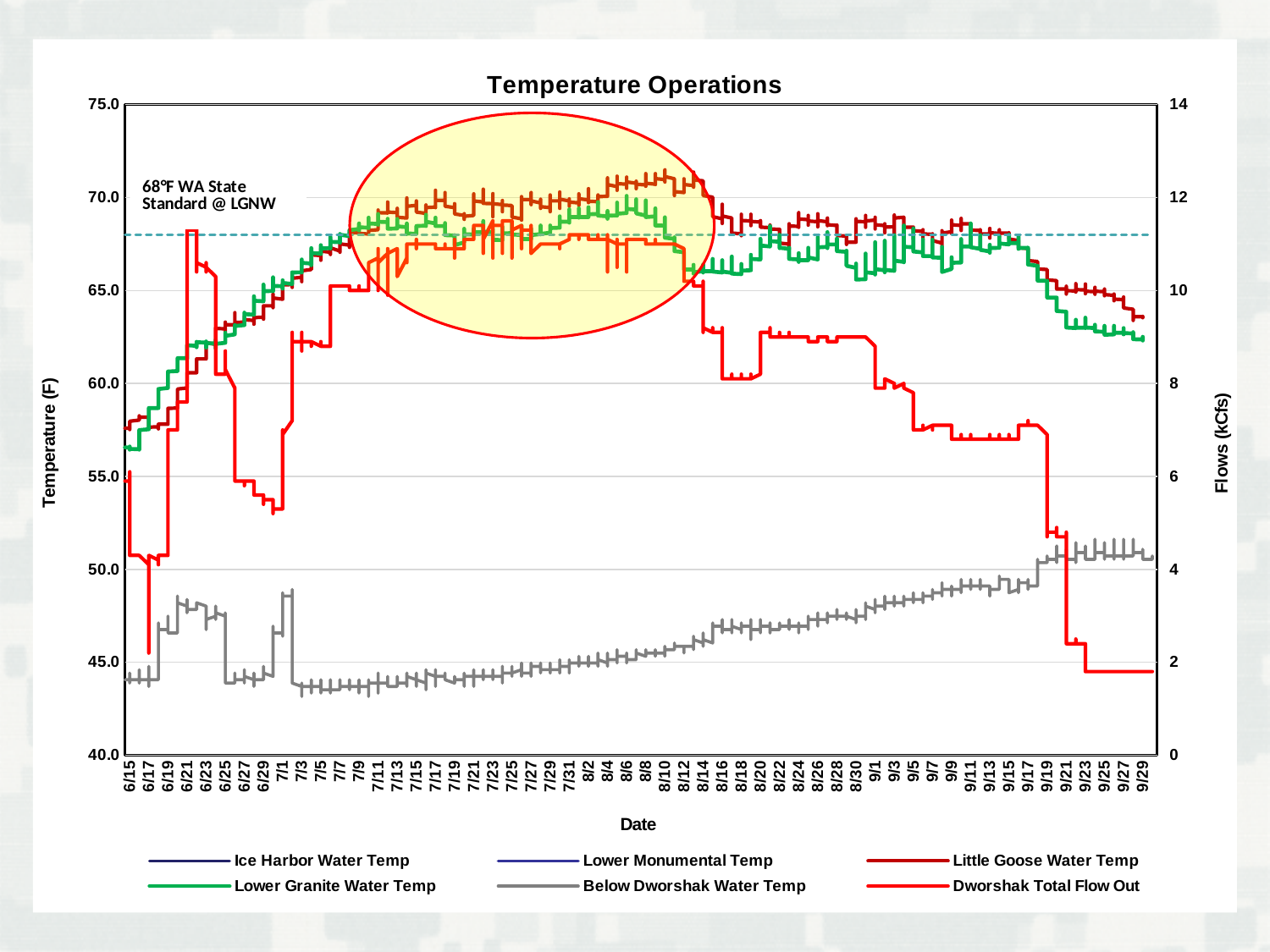
Is the Lower Granite Water Temp value on 9/29 greater or less than 65.0? less Is the Below Dworshak Water Temp value on 7/15 greater or less than 50.0? less Does the Below Dworshak Water Temp series rise or fall between 7/3 and 9/29? rise On 7/1, which is higher: Below Dworshak Water Temp or Lower Granite Water Temp? Lower Granite Water Temp Is the Little Goose Water Temp value on 8/10 greater or less than 65.0? greater What does the text annotation near the dashed horizontal line say? 68°F WA State Standard @ LGNW What is the title of the chart? Temperature Operations How many series does the legend list? 6 What kind of chart is shown on the slide? line chart Does the Dworshak Total Flow Out series rise or fall between 9/17 and 9/29? fall